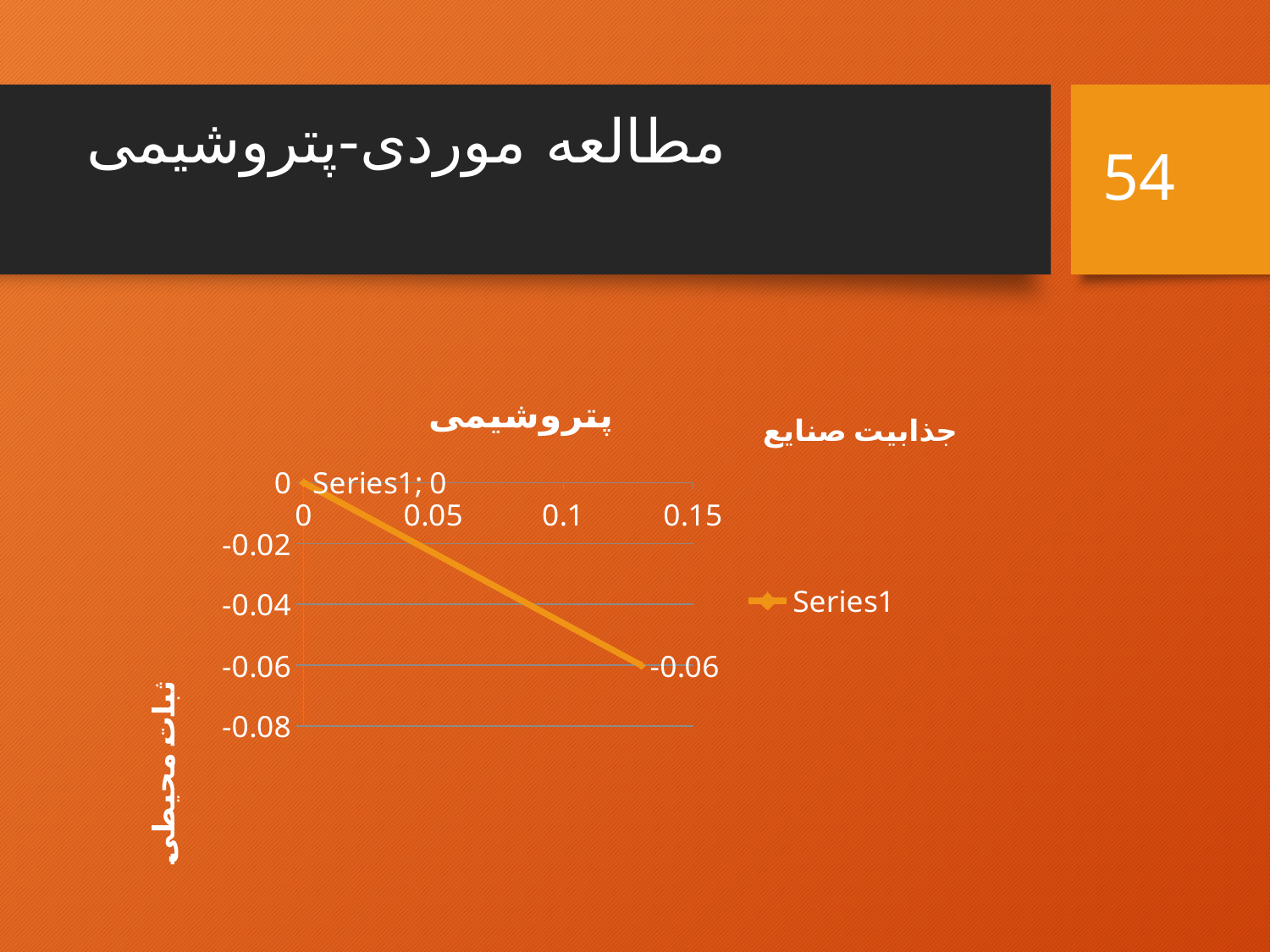
What kind of chart is shown on the slide? line chart What is the lowest y value plotted on the chart? -0.06 Is the x value of the data point labelled -0.06 greater or less than 0.1? greater What is the difference between the y values of the two plotted points? 0.06 Do the values of Series1 rise or fall as x increases? fall What is the y value of the first data point of Series1, at x = 0? 0 What is the highest y value plotted on the chart? 0 What is the name of the series shown in the legend? Series1 What is the y value of the data point labelled at the end of the line? -0.06 How many series does the legend list? 1 What is the title of the chart? پتروشیمی How many data points are plotted on the chart? 2